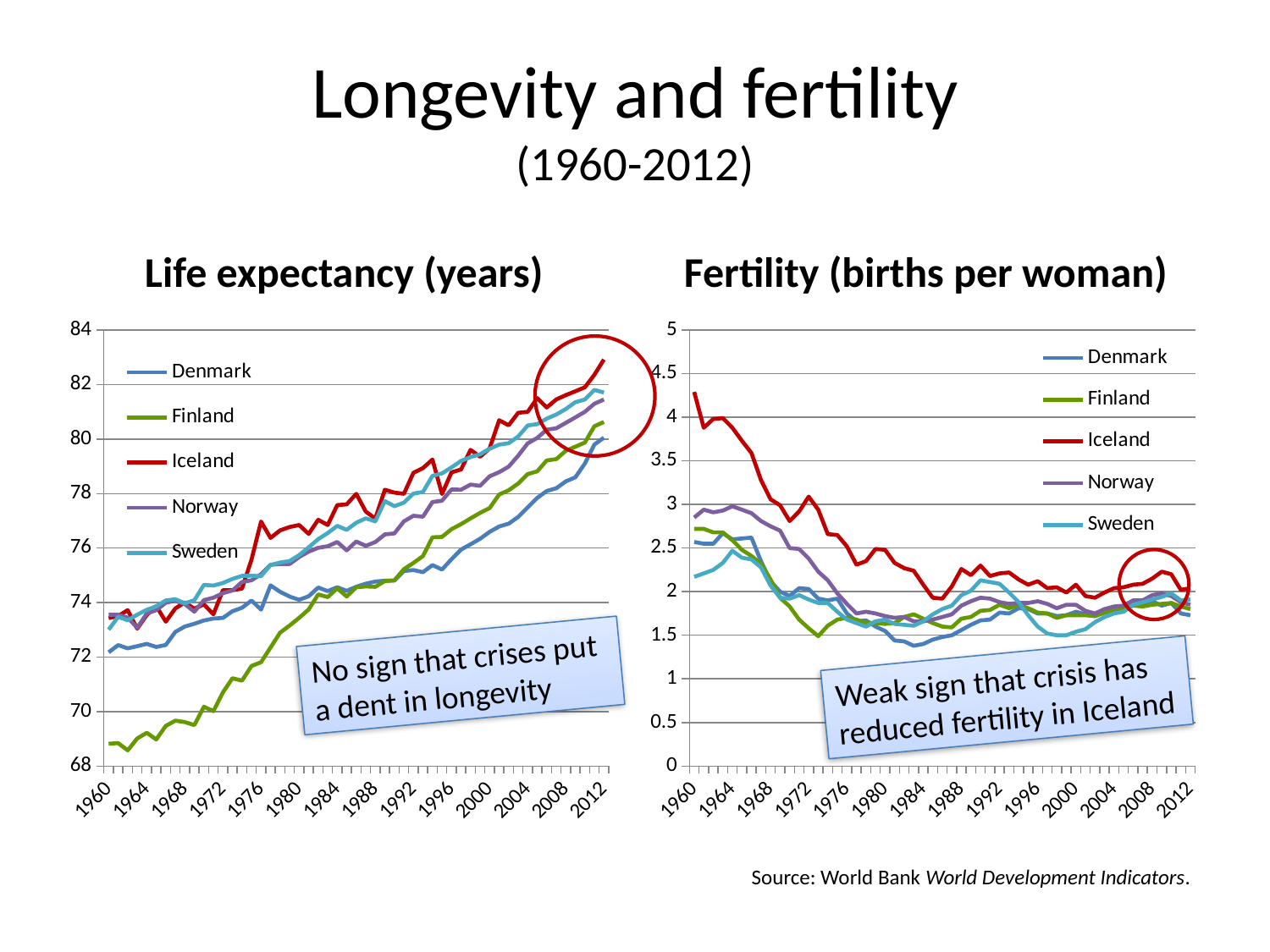
In the Life expectancy (years) chart, is the value for Finland in 1960 greater or less than 70? less How many series does the legend of the Fertility (births per woman) chart list? 5 In the Life expectancy (years) chart, which country has the highest life expectancy in 2012? Iceland In the Fertility (births per woman) chart, do the values generally rise or fall from 1960 to 2012? fall In the Fertility (births per woman) chart, which country is shown with a red line? Iceland In the Fertility (births per woman) chart, which country has the highest fertility in 1960? Iceland In the Fertility (births per woman) chart, is the value for Iceland in 1960 greater or less than 4? greater In the Life expectancy (years) chart, which country has the lowest life expectancy in 1960? Finland In the Life expectancy (years) chart, do the values generally rise or fall from 1960 to 2012? rise In the Fertility (births per woman) chart, is the value for Sweden in 1960 greater or less than 2.5? less What kind of chart is the Life expectancy (years) chart? line chart